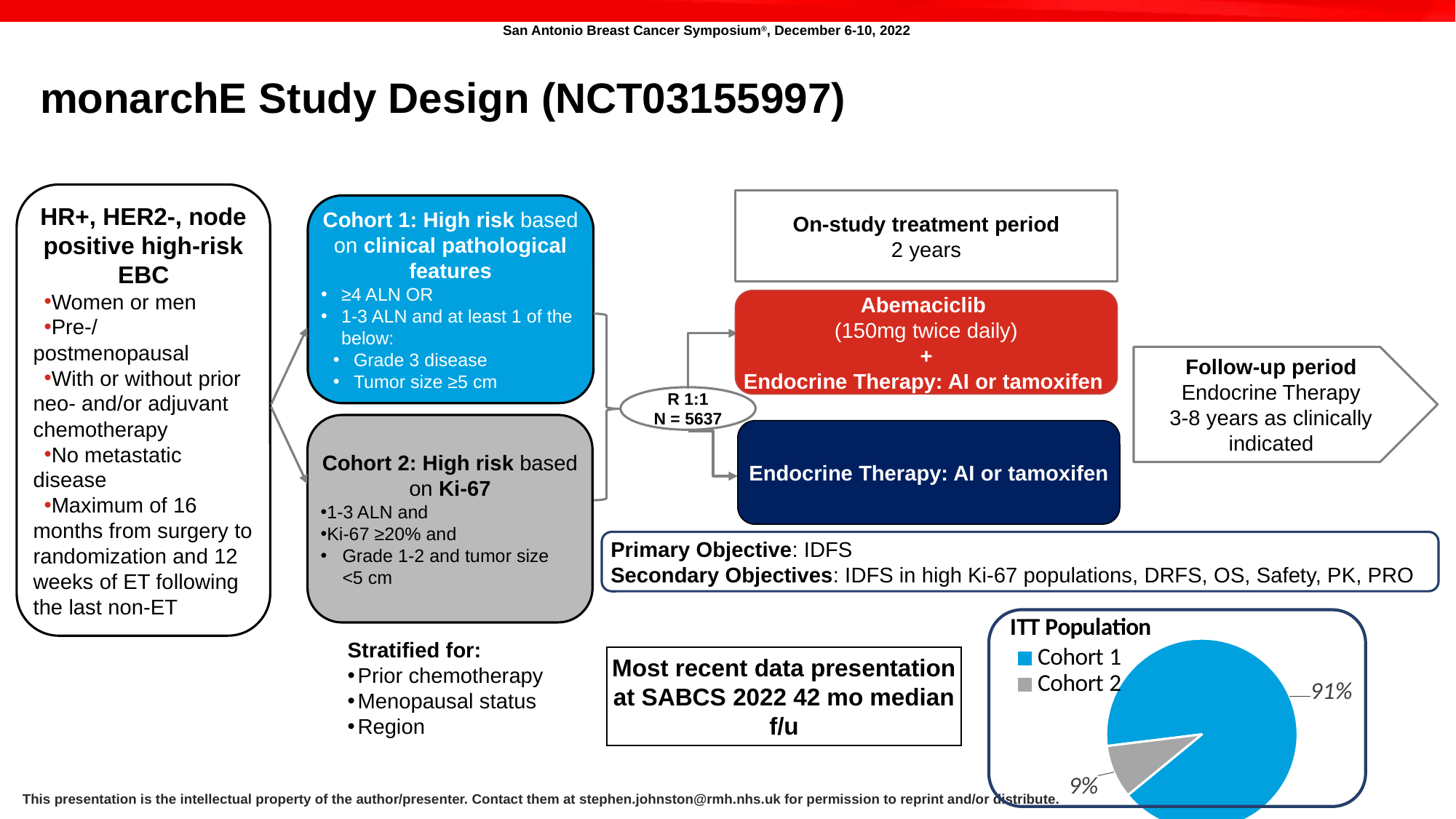
Which cohort has the largest slice in the ITT Population pie chart? Cohort 1 Which cohort has the smallest slice in the ITT Population pie chart? Cohort 2 In the ITT Population pie chart, what colour is the Cohort 2 slice? grey What is the title of the pie chart on the slide? ITT Population How many entries does the legend of the ITT Population pie chart list? 2 In the ITT Population pie chart, what share does Cohort 2 have? 9% What kind of chart is the ITT Population chart? pie chart How many slices does the ITT Population pie chart have? 2 In the ITT Population pie chart, what share does Cohort 1 have? 91% In the ITT Population pie chart, which is larger, Cohort 1 or Cohort 2? Cohort 1 In the ITT Population pie chart, what is the difference in percentage points between Cohort 1 and Cohort 2? 82